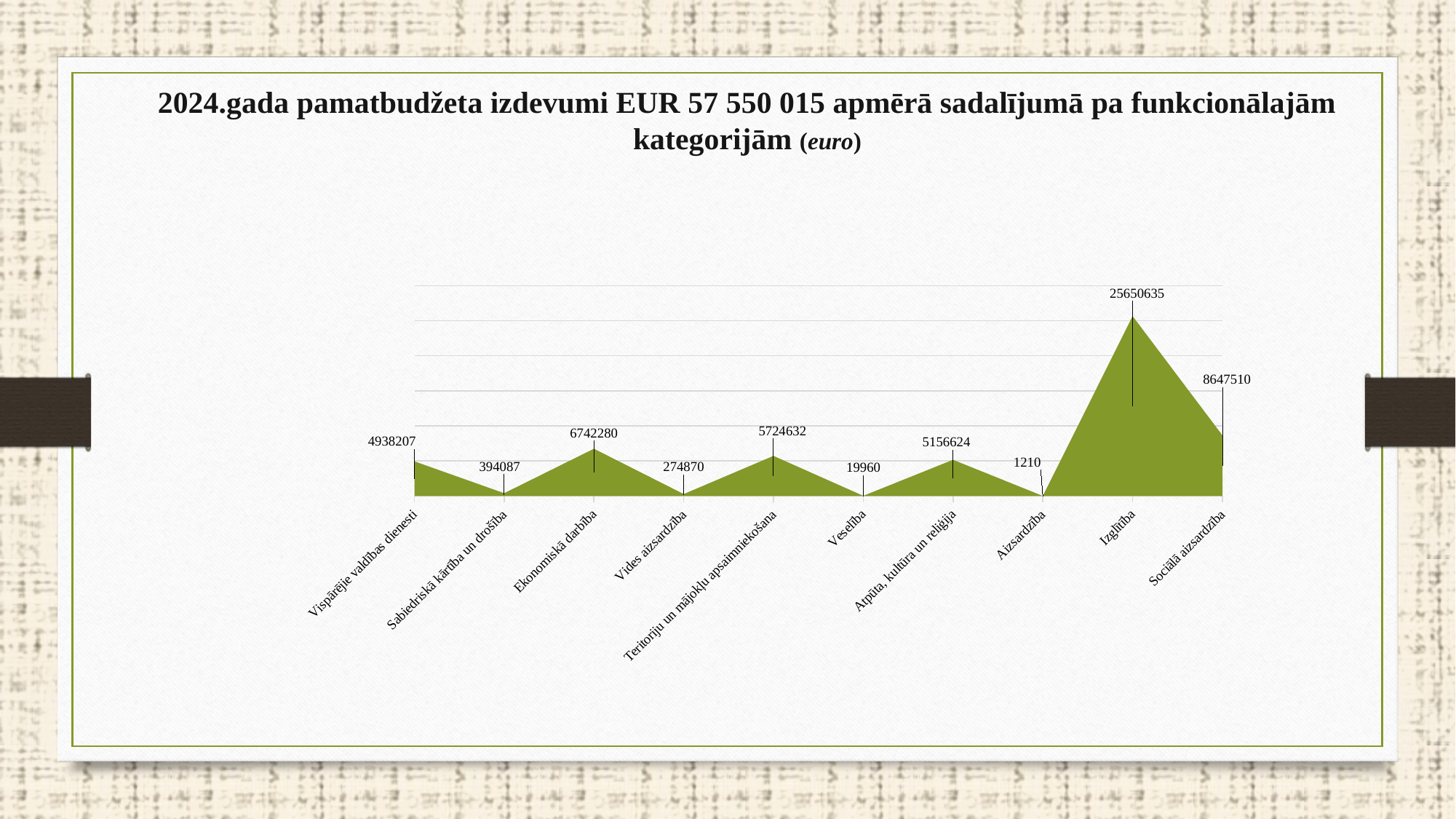
Which category has the lowest value? Aizsardzība What kind of chart is shown on the slide? Area chart What total budget amount is stated in the chart title? EUR 57 550 015 How many categories are shown on the x axis? 10 What is the value for Sociālā aizsardzība? 8647510 Which category has the highest value? Izglītība What is the difference between the values for Ekonomiskā darbība and Teritoriju un mājokļu apsaimniekošana? 1017648 What is the value for Izglītība? 25650635 What is the value for Teritoriju un mājokļu apsaimniekošana? 5724632 What is the value for Veselība? 19960 Which is larger, the value for Vispārējie valdības dienesti or the value for Atpūta, kultūra un reliģija? Atpūta, kultūra un reliģija What is the difference between the values for Izglītība and Sociālā aizsardzība? 17003125